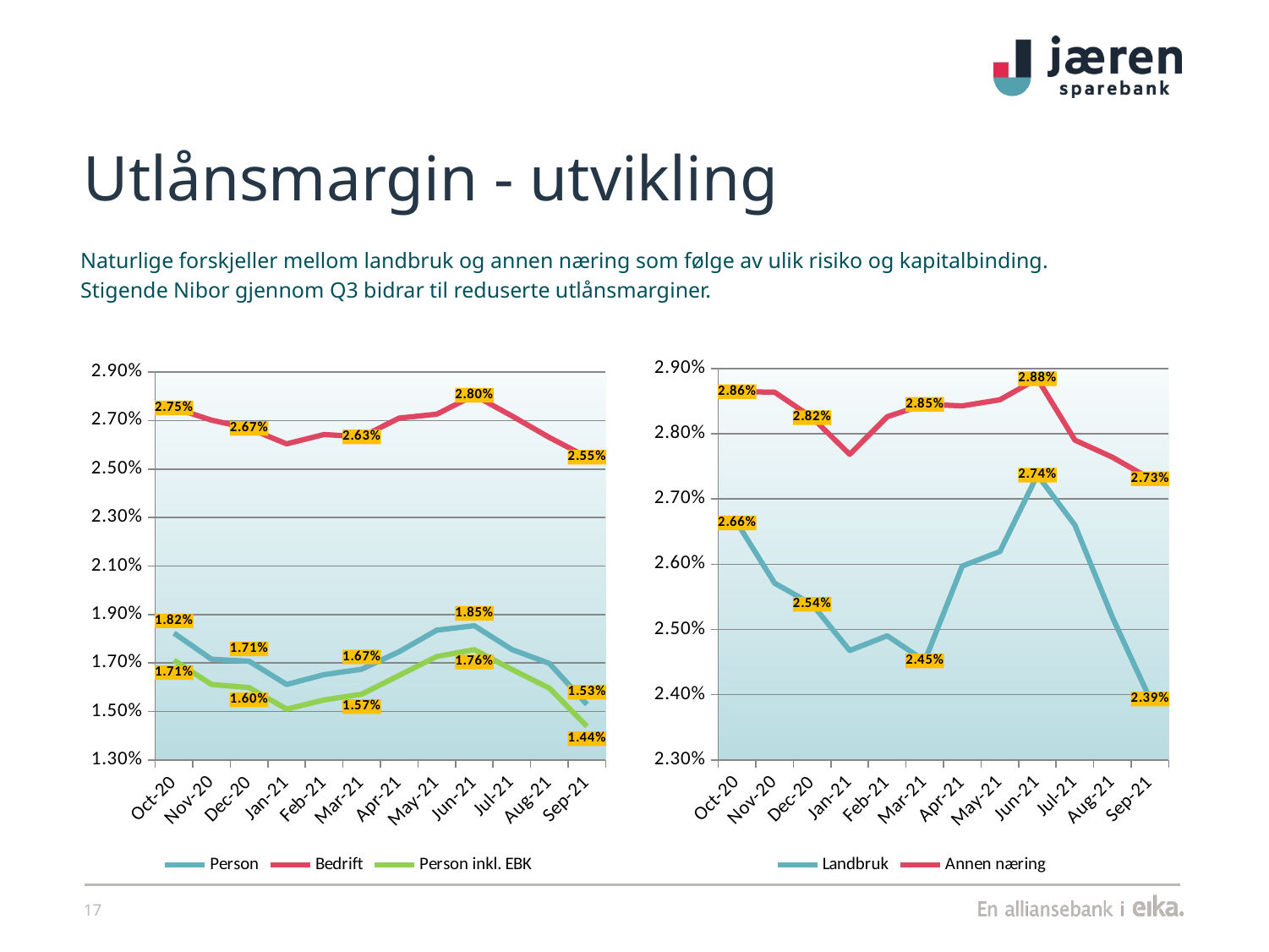
In the left chart, what is the value for Person inkl. EBK in Sep-21? 1.44% What type of chart is the right chart? Line chart How many months are shown on the x axis of the left chart? 12 In the right chart, is the value for Landbruk in Jul-21 greater or less than 2.60%? greater In the left chart, is the value for Bedrift in Jan-21 greater or less than 2.70%? less In the right chart, what is the value for Landbruk in Mar-21? 2.45% How many series does the legend of the left chart list? 3 In the left chart, what is the difference between the Person value in Oct-20 and in Sep-21? 0.29% In the left chart, what is the value for Bedrift in Jun-21? 2.80% In the right chart, what is the value for Annen næring in Oct-20? 2.86% In the right chart, which series has the higher value in Jun-21, Landbruk or Annen næring? Annen næring In the right chart, what is the difference between Annen næring and Landbruk in Sep-21? 0.34%